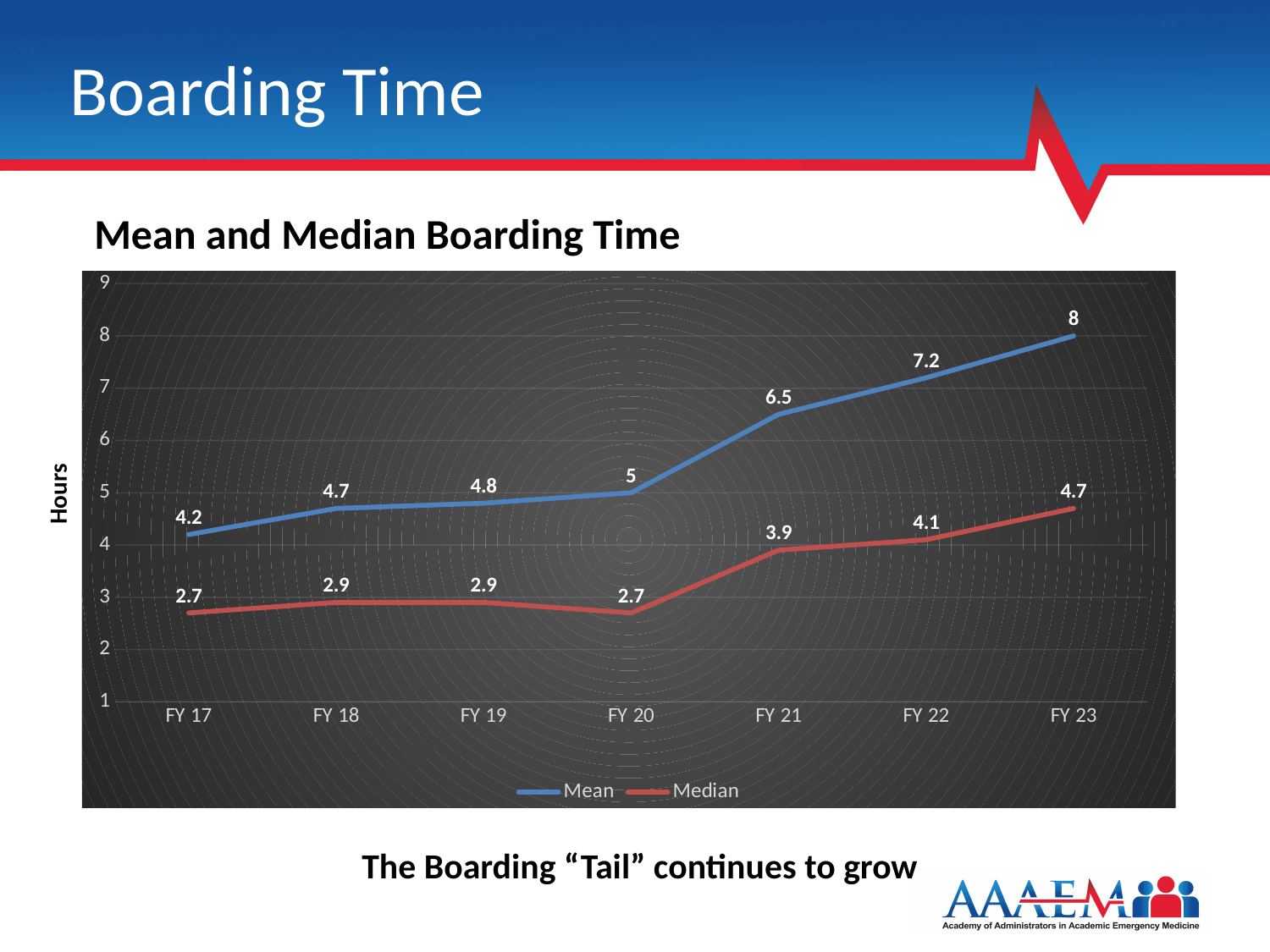
What is the label on the vertical axis? Hours Does the Mean boarding time rise or fall from FY 17 to FY 23? Rise By how much did the Mean boarding time increase from FY 20 to FY 21? 1.5 In which fiscal year is the Mean boarding time highest? FY 23 Which is larger, the Median boarding time in FY 21 or in FY 20? FY 21 What is the Mean boarding time for FY 21? 6.5 How many series does the legend list? 2 How many fiscal years are shown on the x axis? 7 What is the difference between the Mean and Median boarding times in FY 23? 3.3 What is the Median boarding time for FY 18? 2.9 In which fiscal year is the Mean boarding time lowest? FY 17 What kind of chart is shown? Line chart